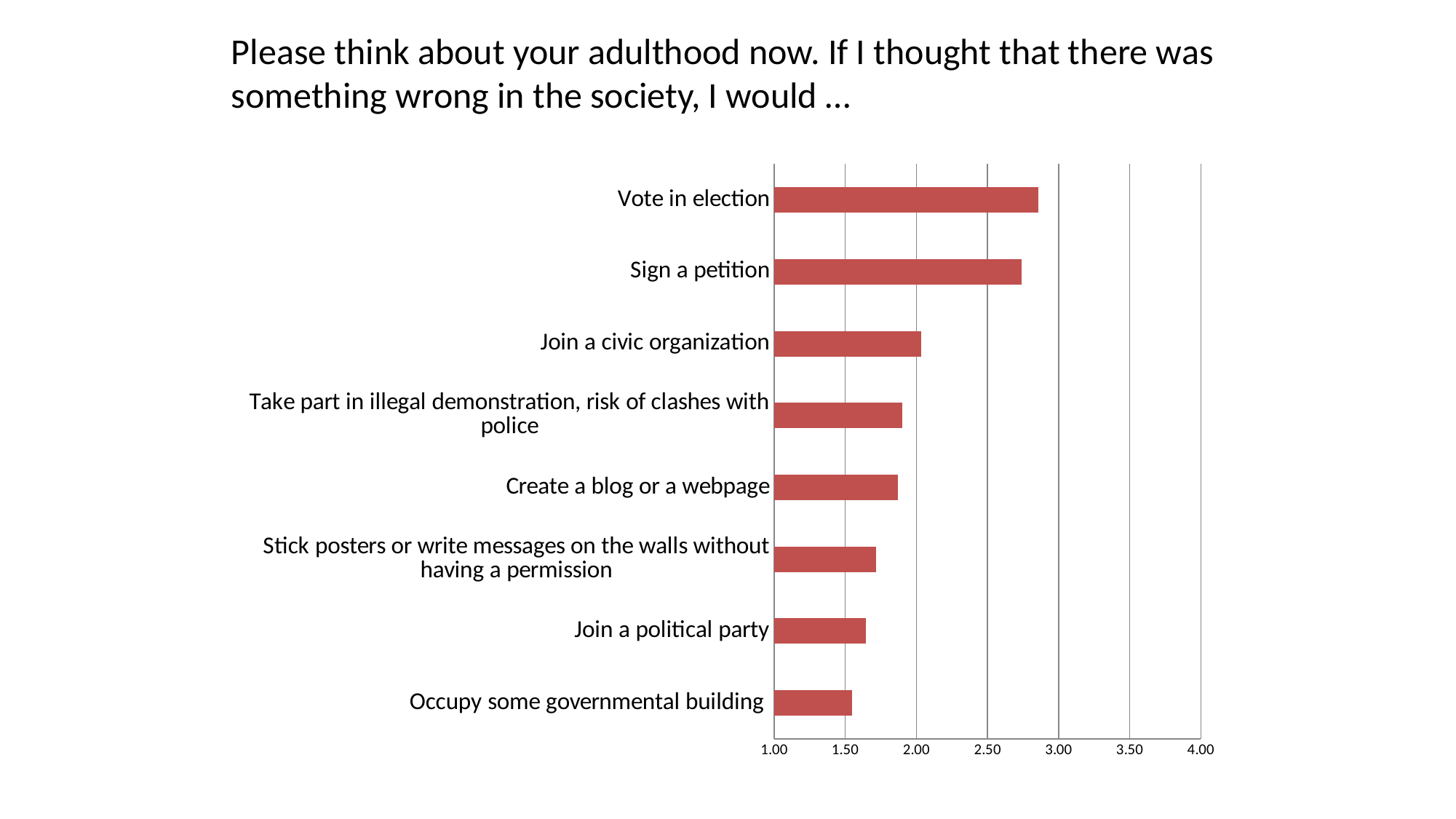
How many categories (actions) are plotted in the chart? 8 Is the value for Vote in election greater or less than 2.50? greater What kind of chart is shown on the slide? bar chart Is the value for Create a blog or a webpage greater or less than 2.00? less Which has a larger value: Sign a petition or Occupy some governmental building? Sign a petition Which action has the lowest value in the chart? Occupy some governmental building Which action has the highest value in the chart? Vote in election Is the value for Join a political party greater or less than 2.00? less What is the maximum value shown on the horizontal axis of the chart? 4.00 Which has a larger value: Vote in election or Join a civic organization? Vote in election